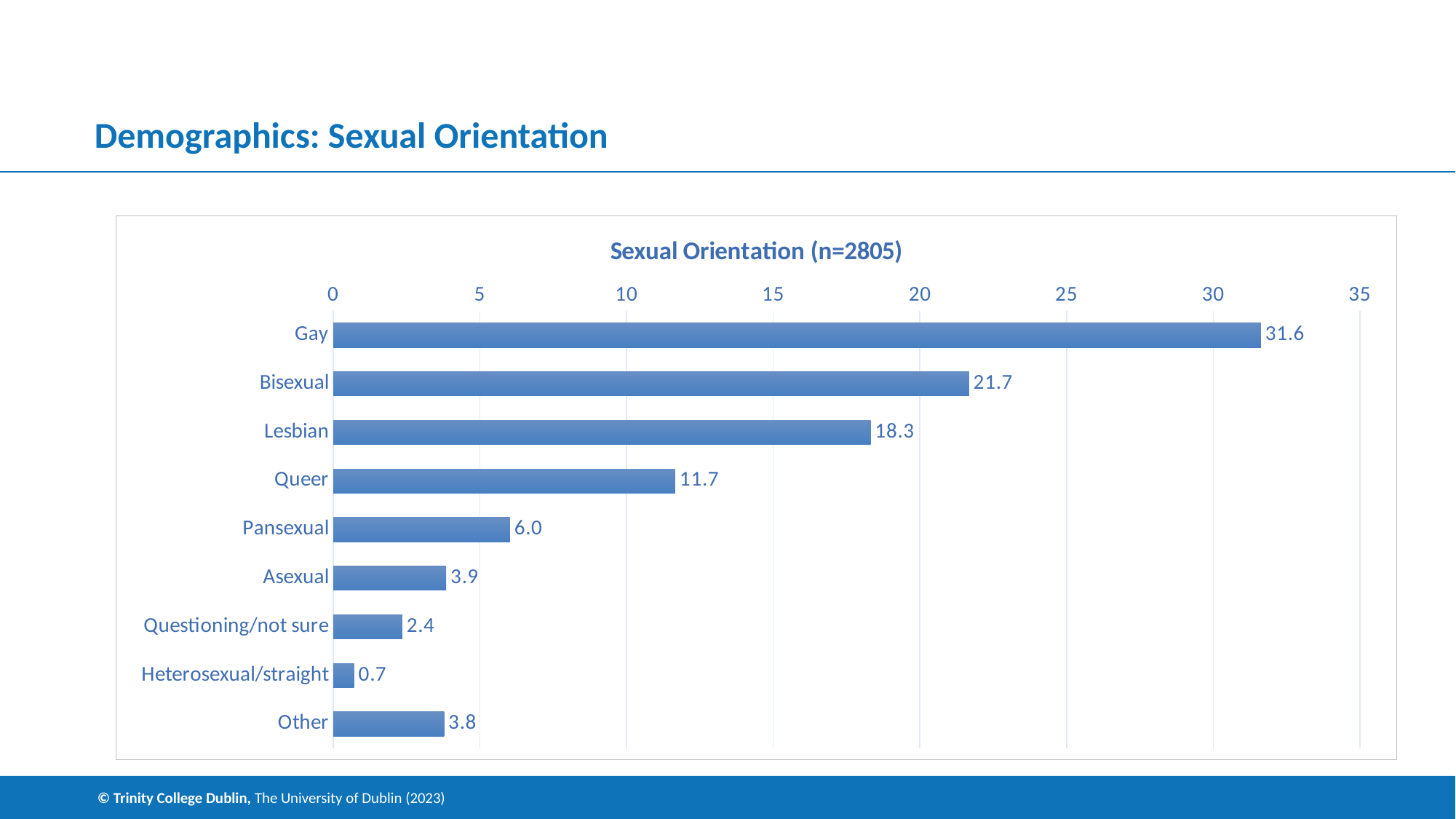
What is the value for Gay? 31.6 What kind of chart is shown on the slide? Bar chart Which is larger, the value for Asexual or the value for Other? Asexual What is the difference between the values for Gay and Bisexual? 9.9 Which category has the lowest value? Heterosexual/straight What is the value for Questioning/not sure? 2.4 What is the value for Lesbian? 18.3 What is the difference between the values for Queer and Pansexual? 5.7 Is the value for Bisexual greater or less than 20? greater Which category has the highest value? Gay What is the title of the chart? Sexual Orientation (n=2805) How many categories are shown in the chart? 9